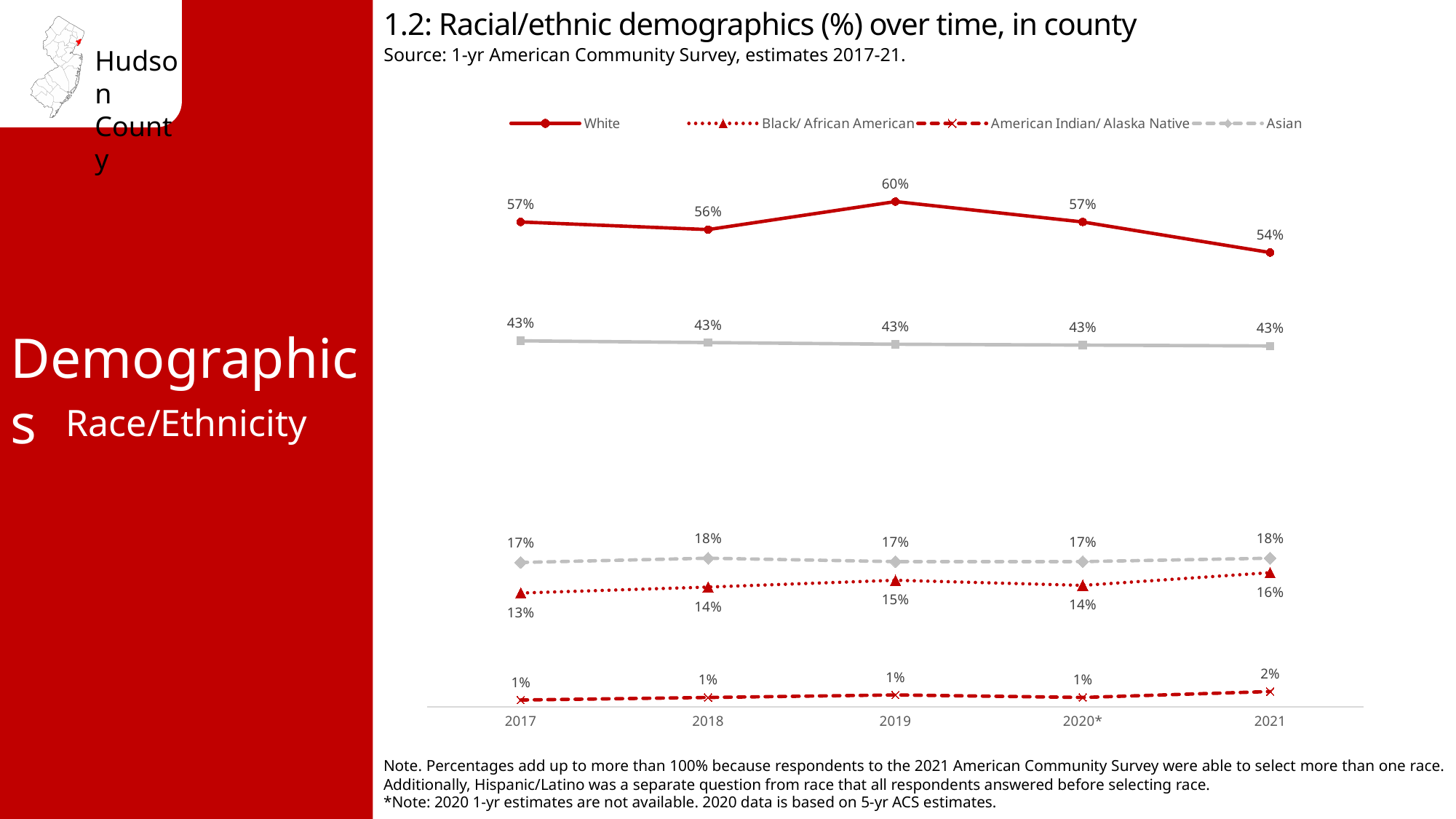
In which year is the White percentage lowest? 2021 In which year is the White percentage highest? 2019 What is the value for Black/ African American in 2017? 13% What is the value for American Indian/ Alaska Native in 2021? 2% What is the value for Asian in 2018? 18% What kind of chart is shown on the slide? Line chart Does the Black/ African American percentage rise or fall from 2017 to 2021 overall? Rise How many years are shown on the x axis? 5 What is the value for White in 2021? 54% What is the value for White in 2019? 60% What is the difference between the White value in 2019 and in 2021? 6 percentage points In 2021, which is larger: the Asian value or the Black/ African American value? Asian